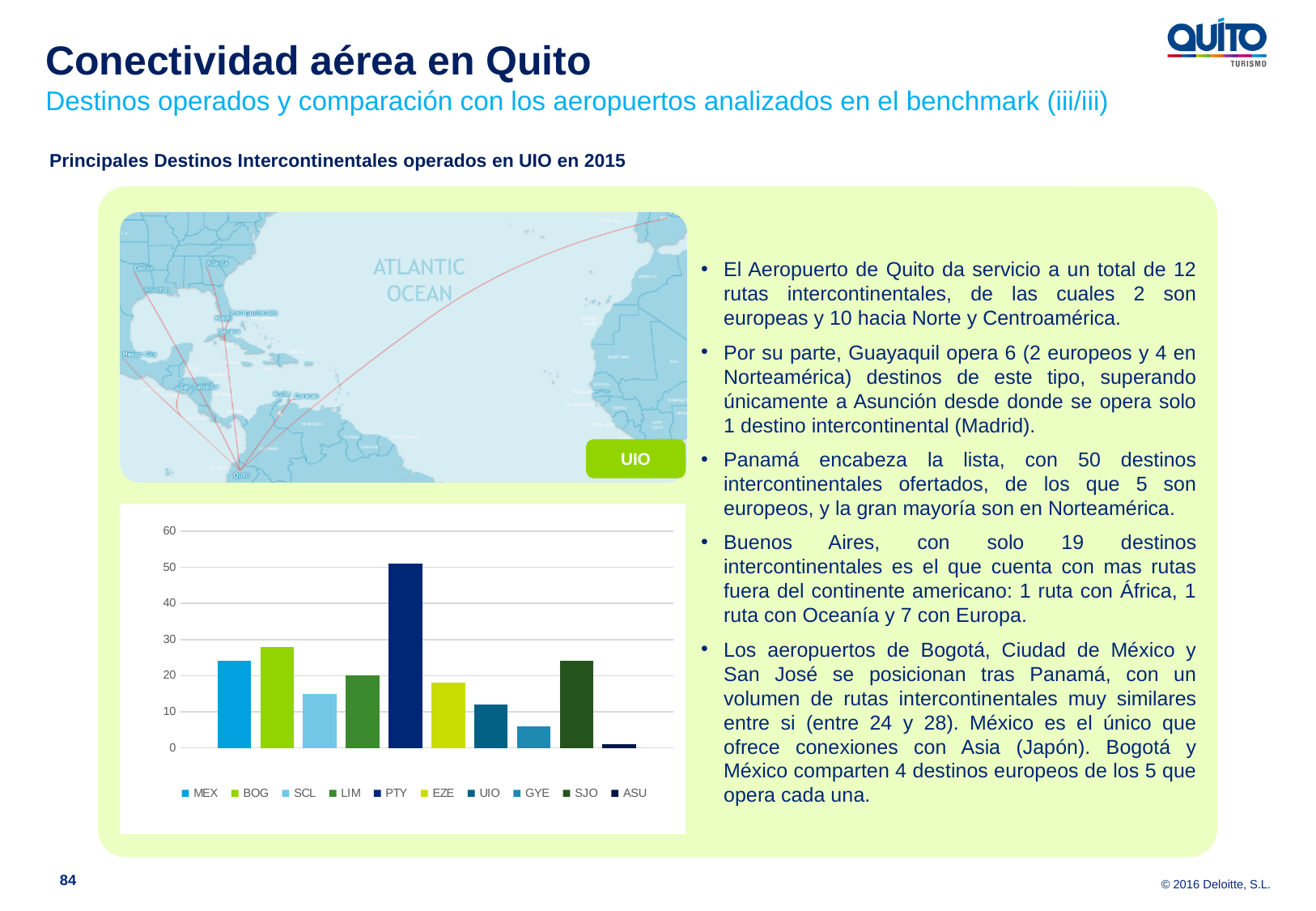
Is the value for BOG greater or less than 20? greater How many airports (bars) are plotted in the chart? 10 Which airport has the highest bar in the chart? PTY Which has the larger value, SCL or LIM? LIM Which airport has the lowest bar in the chart? ASU Is the value for PTY greater or less than 40? greater How many entries does the chart legend list? 10 What is the highest value shown on the chart's vertical axis? 60 What kind of chart is shown on the slide? bar chart Is the value for GYE greater or less than 10? less Which has the larger value, UIO or GYE? UIO